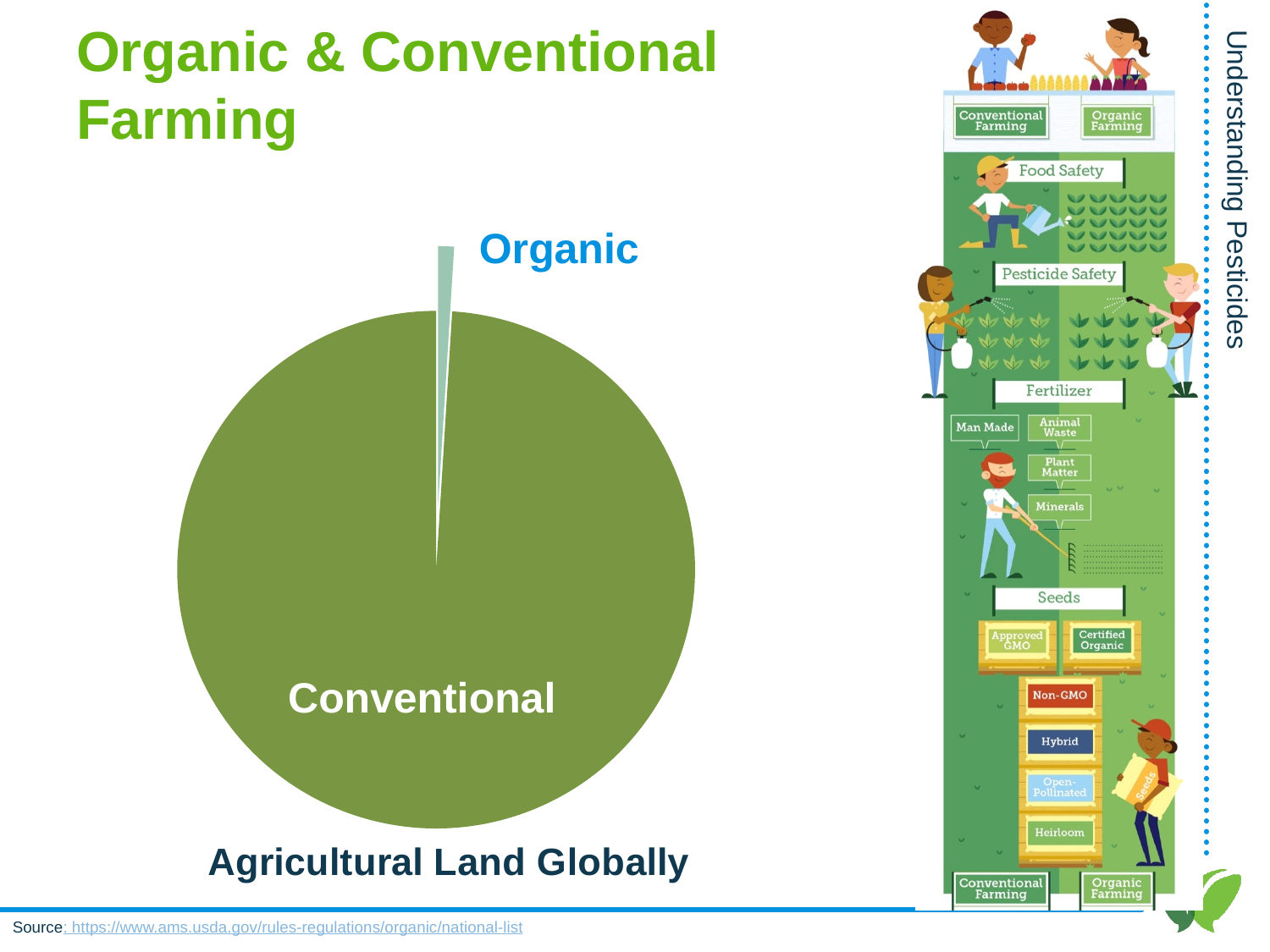
Which slice of the pie chart is pulled out (exploded) from the rest of the pie? Organic What are the names of the two categories in the pie chart? Organic and Conventional How many slices does the pie chart have? 2 Which category has the largest slice of the pie chart? Conventional What kind of chart is shown on the slide? pie chart What is the title shown beneath the pie chart? Agricultural Land Globally Does Organic or Conventional take up the smaller share of the pie? Organic Which is larger in the pie chart, Organic or Conventional? Conventional Which category has the smallest slice of the pie chart? Organic